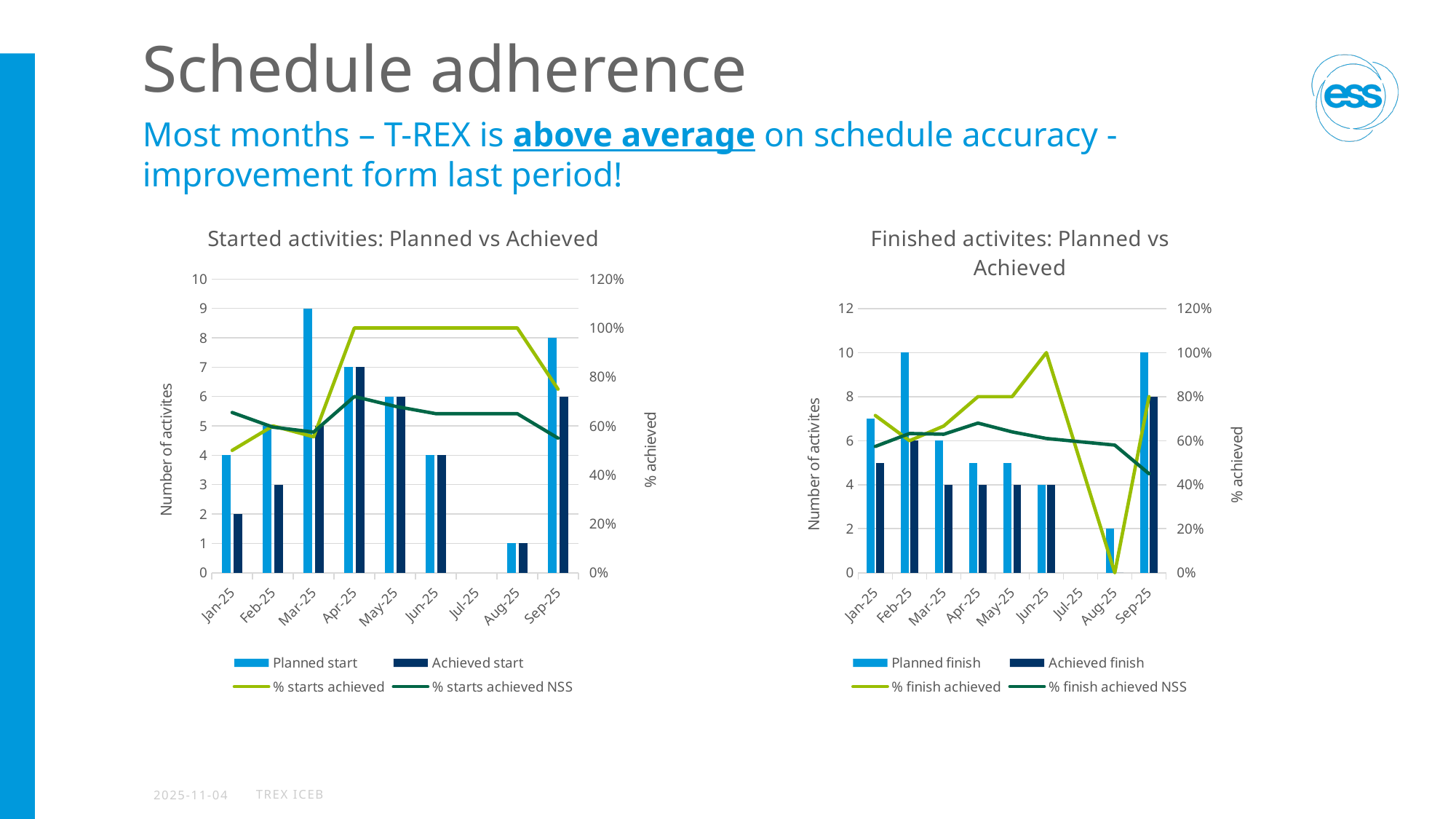
In the 'Finished activites: Planned vs Achieved' chart, what is the Achieved finish value for Sep-25? 8 How many months are shown on the x axis of the 'Finished activites: Planned vs Achieved' chart? 9 In the 'Started activities: Planned vs Achieved' chart, which month has the highest Planned start value? Mar-25 In the 'Started activities: Planned vs Achieved' chart, what is the difference between Planned start and Achieved start in Mar-25? 4 In the 'Started activities: Planned vs Achieved' chart, what is the '% starts achieved' value for Apr-25? 100% In the 'Finished activites: Planned vs Achieved' chart, what is the Planned finish value for Feb-25? 10 How many series does the legend of the 'Started activities: Planned vs Achieved' chart list? 4 In the 'Started activities: Planned vs Achieved' chart, what is the Achieved start value for Sep-25? 6 What kind of chart is the 'Started activities: Planned vs Achieved' chart? A combined bar and line chart In the 'Started activities: Planned vs Achieved' chart, what is the Planned start value for Mar-25? 9 In the 'Finished activites: Planned vs Achieved' chart, what is the '% finish achieved' value for Aug-25? 0% In the 'Finished activites: Planned vs Achieved' chart, which is larger: the Planned finish for Feb-25 or for Mar-25? Feb-25